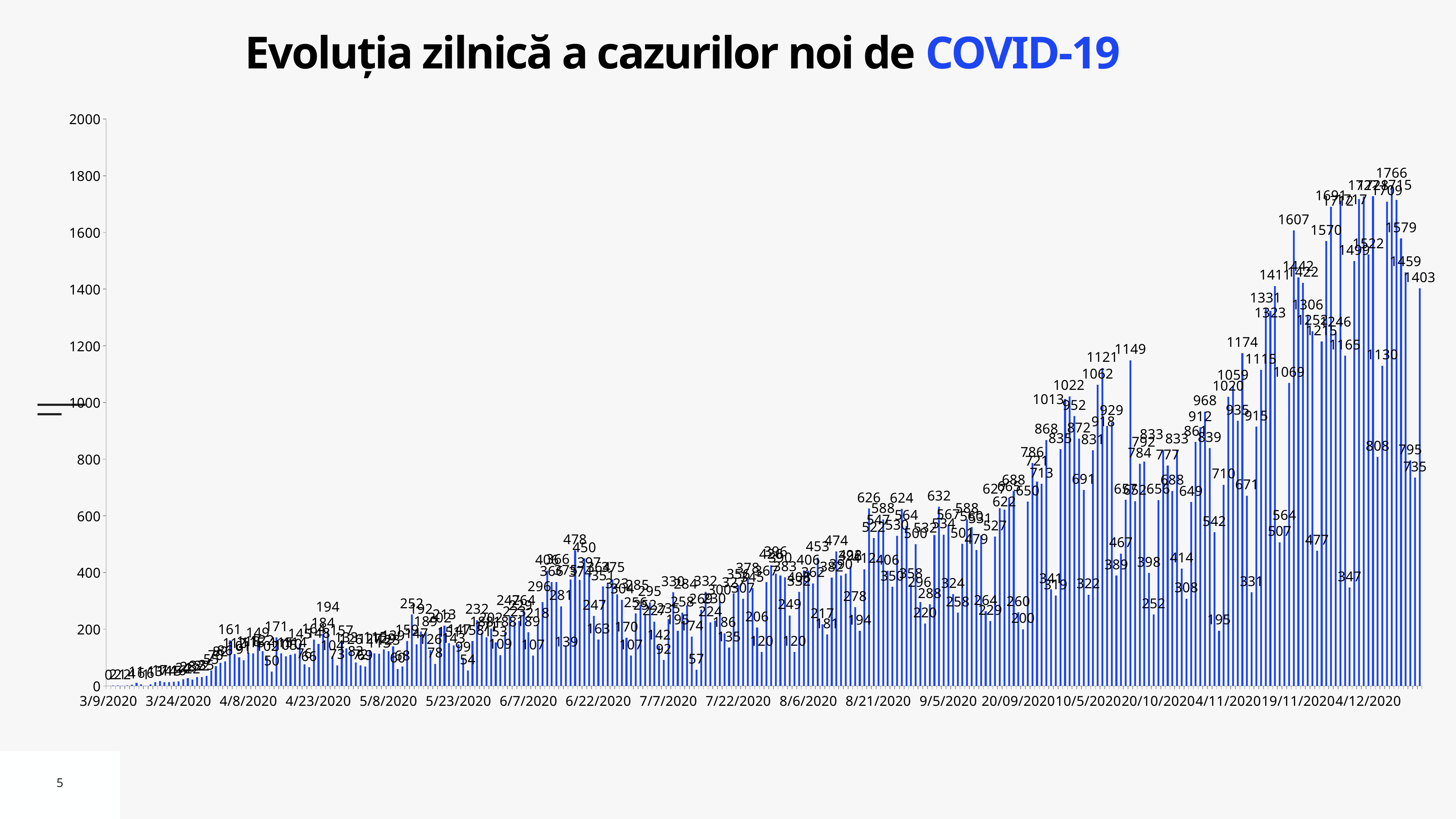
What is the first date shown on the x axis? 3/9/2020 Is the highest bar on the chart greater or less than 1600? greater What is the maximum value shown on the y axis? 2000 Which is larger, the bar labeled 1607 or the bar labeled 1766? 1766 What is the highest daily value labeled on the chart? 1766 What is the title of the chart? Evoluția zilnică a cazurilor noi de COVID-19 Is the highest bar on the chart greater or less than 1800? less What is the value labeled on the rightmost (last) bar of the chart? 1403 Overall, do the daily values rise or fall from left to right along the x axis? rise Is the rightmost bar greater or less than 1200? greater What is the difference between the highest labeled value (1766) and the rightmost bar's value (1403)? 363 What kind of chart is shown on the slide? bar chart